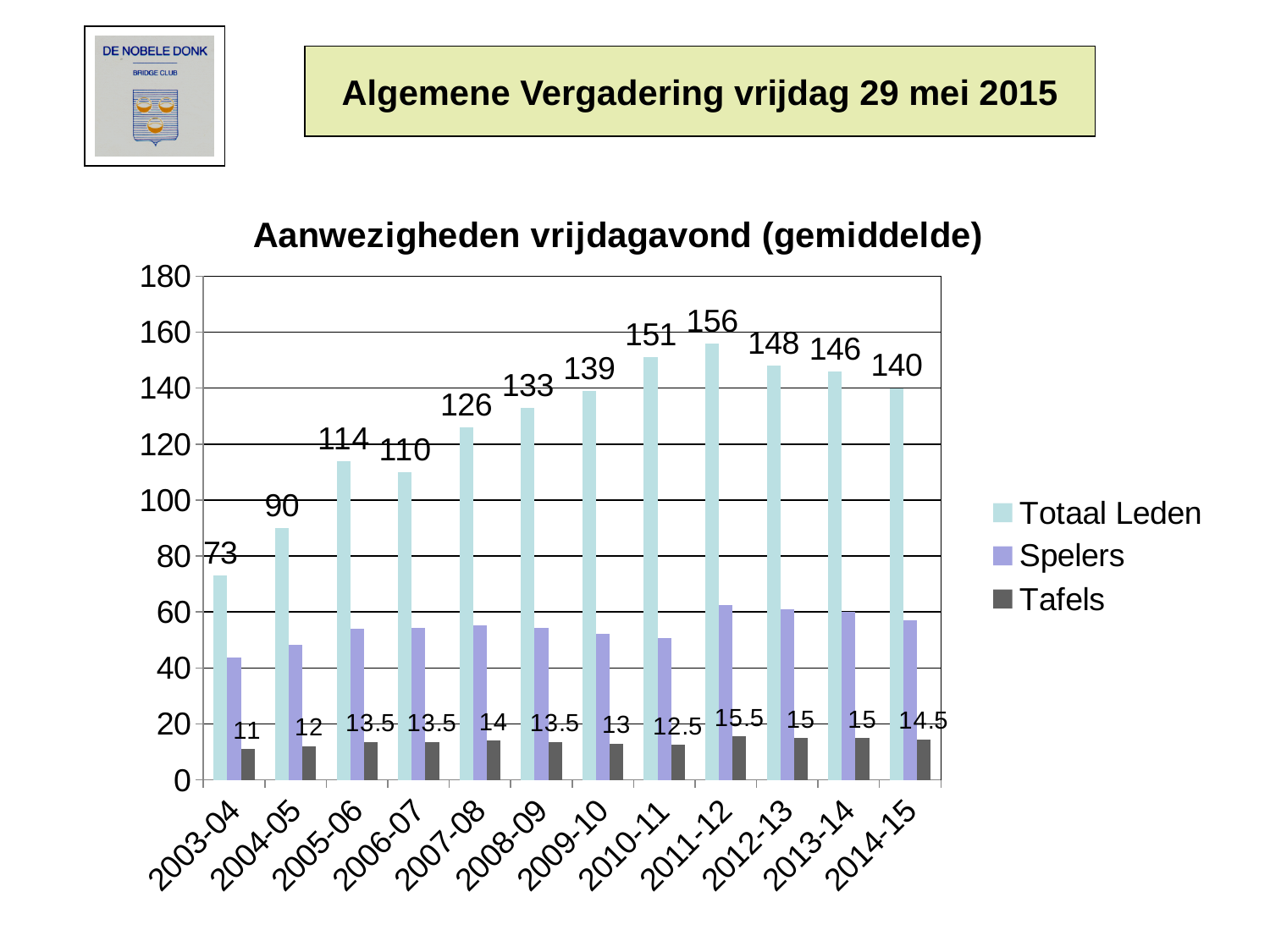
Is the Spelers value for 2007-08 greater or less than 60? less What kind of chart is shown on the slide? Bar chart Which is larger, the Totaal Leden value for 2005-06 or for 2006-07? 2005-06 What is the Tafels value for 2003-04? 11 Is the Spelers value for 2003-04 greater or less than 40? greater Which season has the lowest Tafels value? 2003-04 What is the Totaal Leden value for 2014-15? 140 How many seasons are shown on the x axis? 12 Which season has the highest Totaal Leden value? 2011-12 How many series does the legend list? 3 What is the Totaal Leden value for 2011-12? 156 What is the difference between the Totaal Leden values for 2011-12 and 2003-04? 83